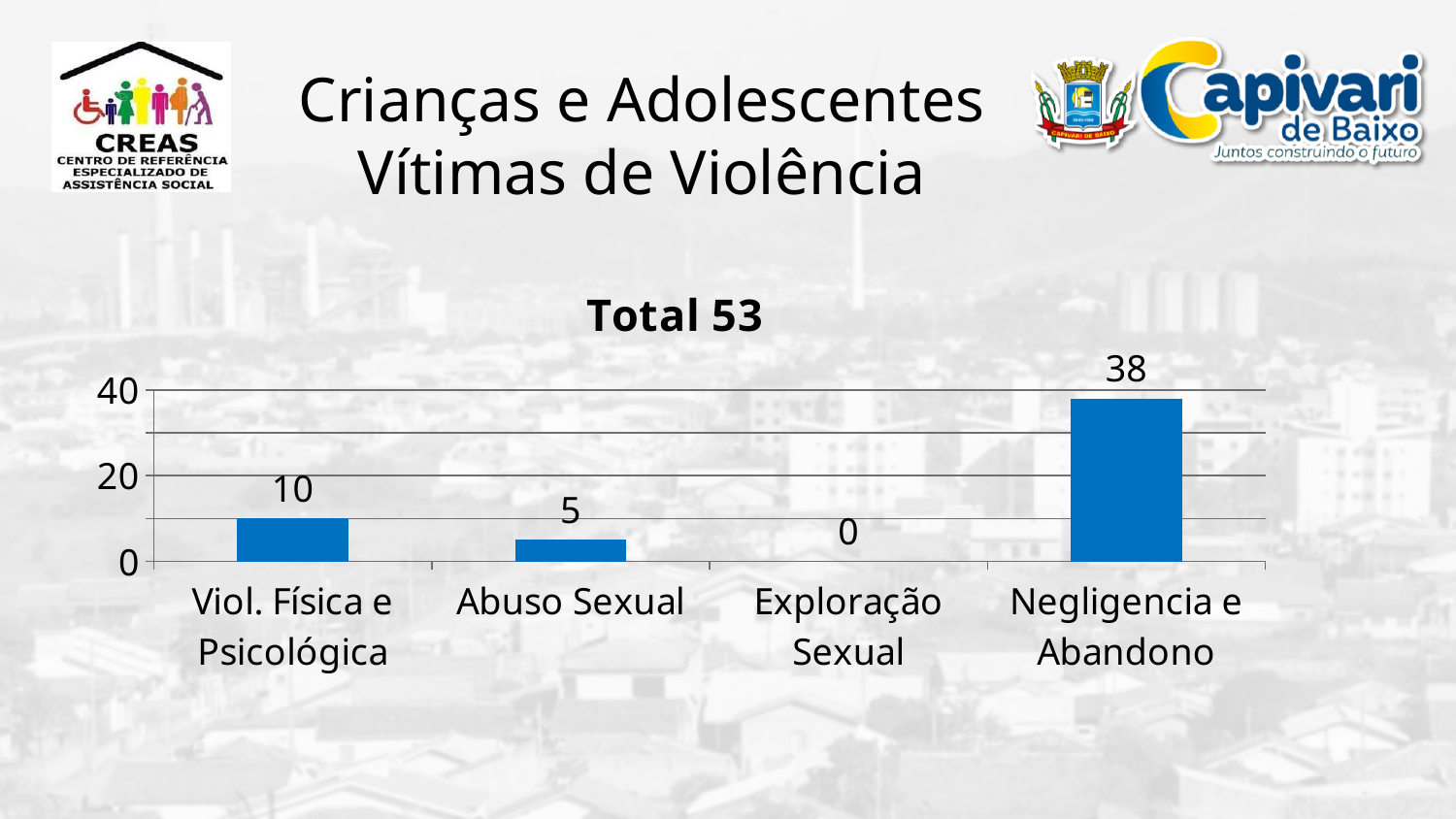
What is the value for Negligencia e Abandono? 38 What is the title of the chart? Total 53 What is the difference between the values for Negligencia e Abandono and Viol. Física e Psicológica? 28 Which category has the lowest value? Exploração Sexual How many categories are shown on the chart? 4 Which is larger, the value for Viol. Física e Psicológica or the value for Abuso Sexual? Viol. Física e Psicológica Is the value for Negligencia e Abandono greater or less than 20? greater What is the value for Abuso Sexual? 5 What is the value for Exploração Sexual? 0 What kind of chart is shown on the slide? bar chart Which category has the highest value? Negligencia e Abandono What is the value for Viol. Física e Psicológica? 10